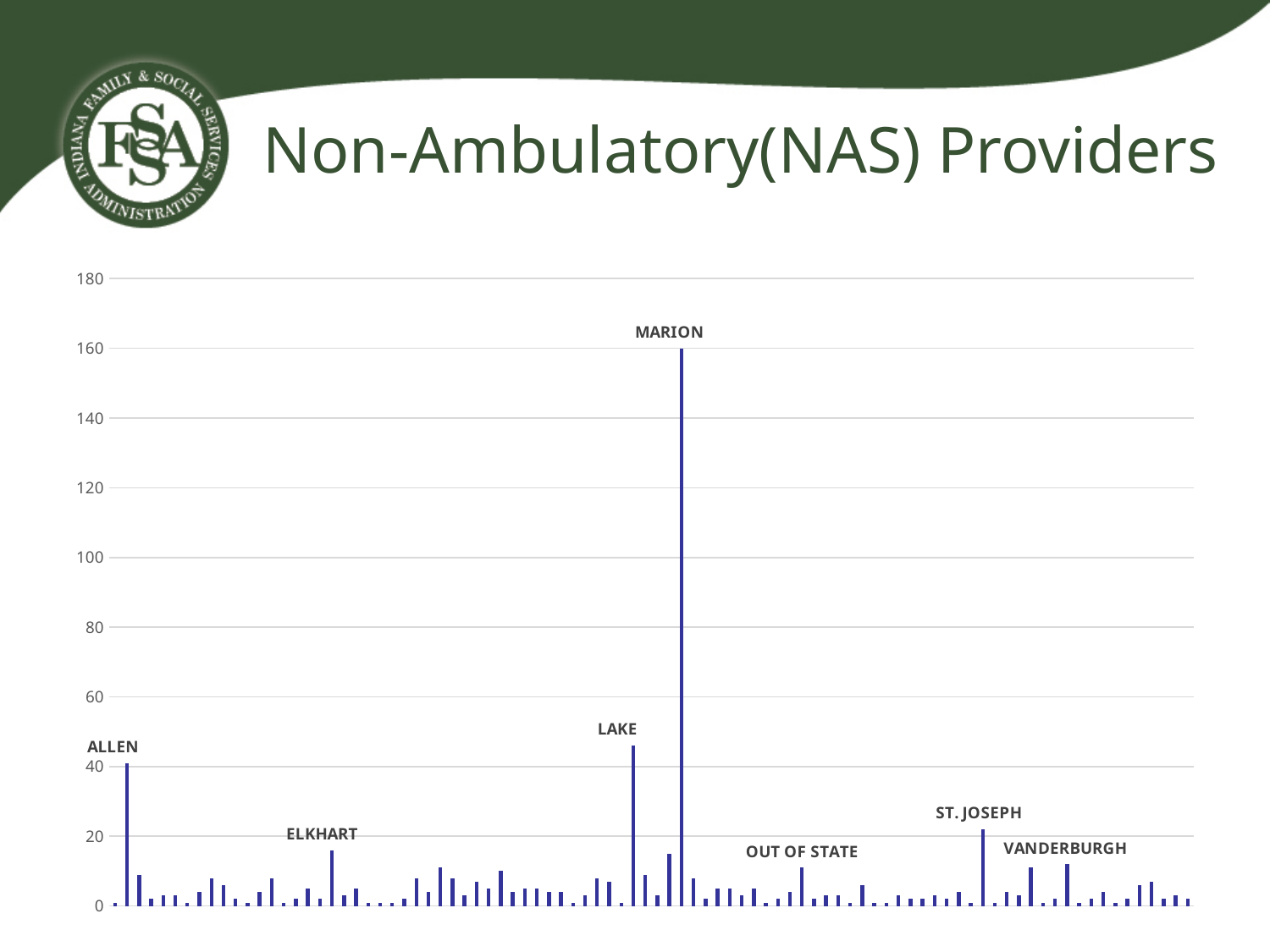
Is the value for MARION greater or less than 140? greater Is the value for ALLEN greater or less than 60? less Is the value for ST. JOSEPH greater or less than 40? less Which has a larger value, ST. JOSEPH or VANDERBURGH? ST. JOSEPH What kind of chart is shown on the slide? bar chart Which labeled category has the highest value? MARION Which has a larger value, MARION or LAKE? MARION Which has a larger value, LAKE or ELKHART? LAKE What is the title of the slide containing the chart? Non-Ambulatory(NAS) Providers